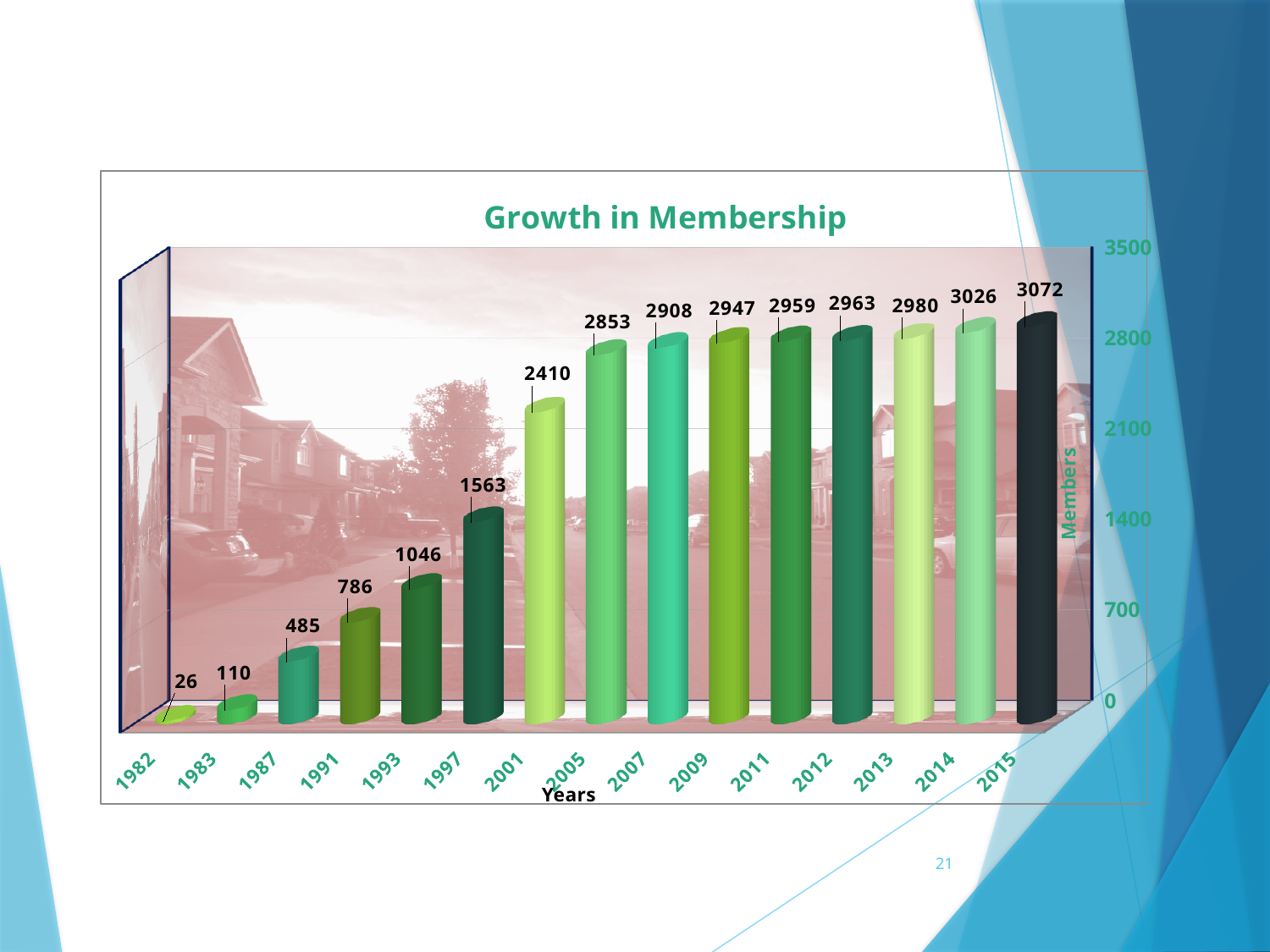
What is the membership value for 2001? 2410 Which year has the lowest membership? 1982 How many years are shown on the x axis? 15 What is the difference in membership between 2001 and 1997? 847 What is the difference in membership between 2015 and 2014? 46 Which year has a larger membership, 1993 or 1997? 1997 What kind of chart is shown on the slide? Bar chart What is the membership value for 1987? 485 Do the membership values rise or fall from 1982 to 2015? Rise Which year has the highest membership? 2015 What is the membership value for 2015? 3072 What is the title of the chart? Growth in Membership